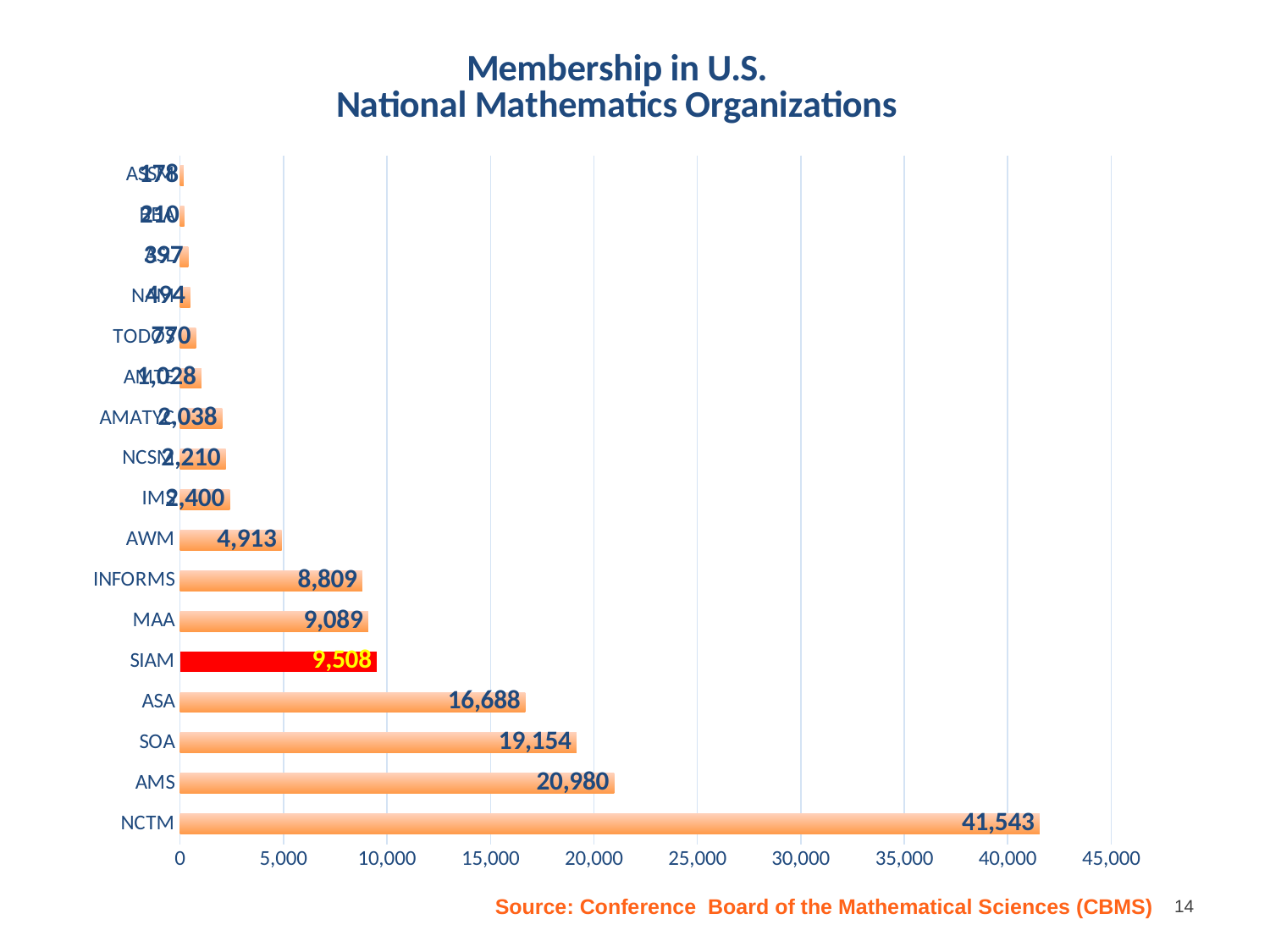
Which bar is highlighted in red in the chart? SIAM What is the difference in membership between SIAM and MAA? 419 How many organizations (bars) are shown in the chart? 17 What type of chart is shown on the slide? bar chart Which organization has the highest membership? NCTM What is the membership value for SIAM? 9,508 Is the membership value for AWM greater or less than 5,000? less What is the membership value for AMS? 20,980 What is the membership value for NCTM? 41,543 Which has a larger membership, ASA or SOA? SOA What is the difference in membership between AMS and SOA? 1,826 What is the membership value for INFORMS? 8,809